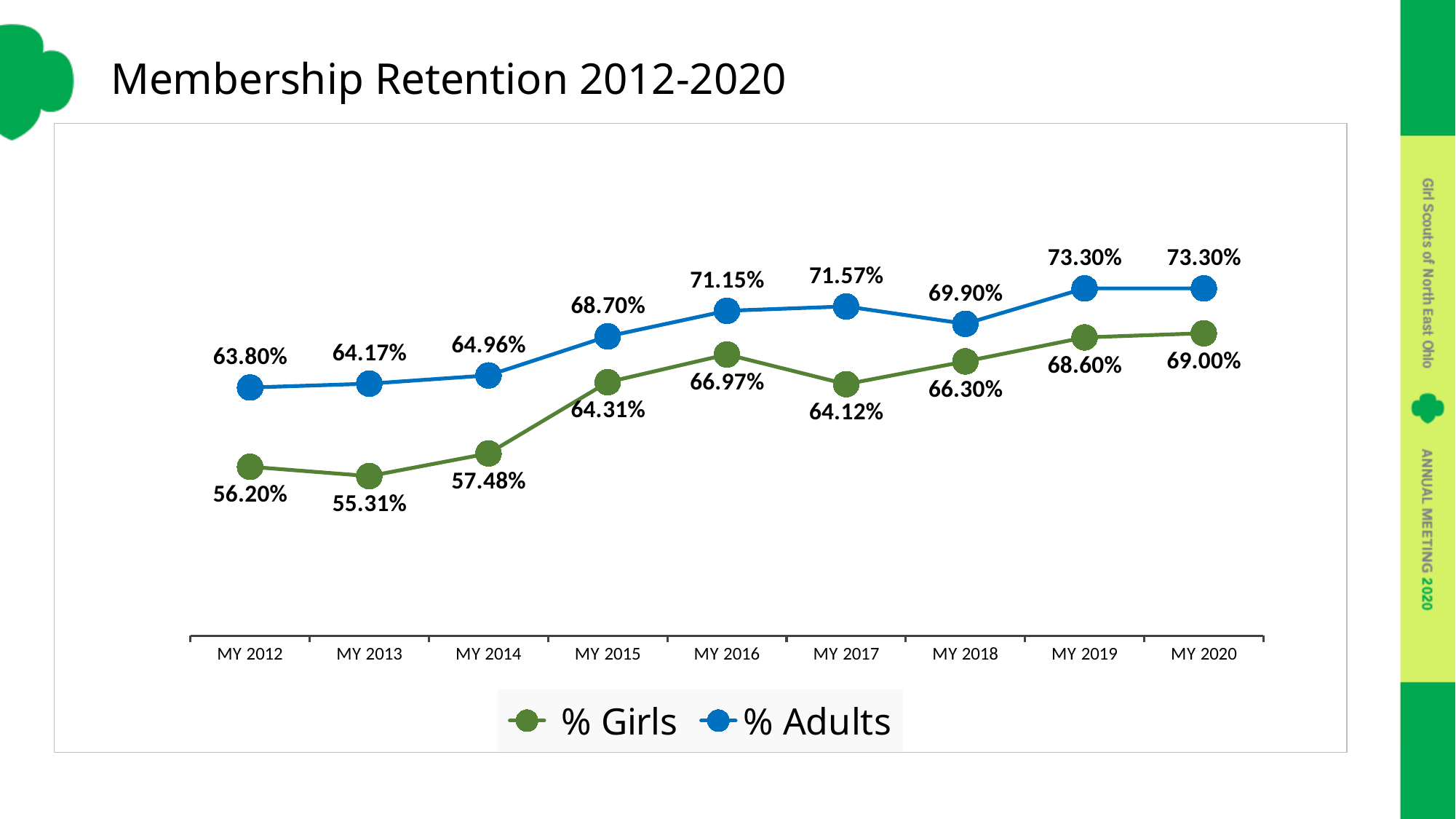
In which membership year is the % Girls value lowest? MY 2013 What is the % Girls retention value for MY 2012? 56.20% What is the difference between the % Girls values in MY 2020 and MY 2012? 12.80% Which is larger in MY 2016, the % Girls value or the % Adults value? % Adults How many series does the legend list? 2 What kind of chart is shown on the slide? Line chart What is the title of the chart? Membership Retention 2012-2020 What is the % Girls retention value for MY 2020? 69.00% How many membership years are shown on the x axis? 9 In which membership year is the % Adults value lowest? MY 2012 What is the % Adults retention value for MY 2017? 71.57% What is the difference between the % Adults and % Girls values in MY 2012? 7.60%